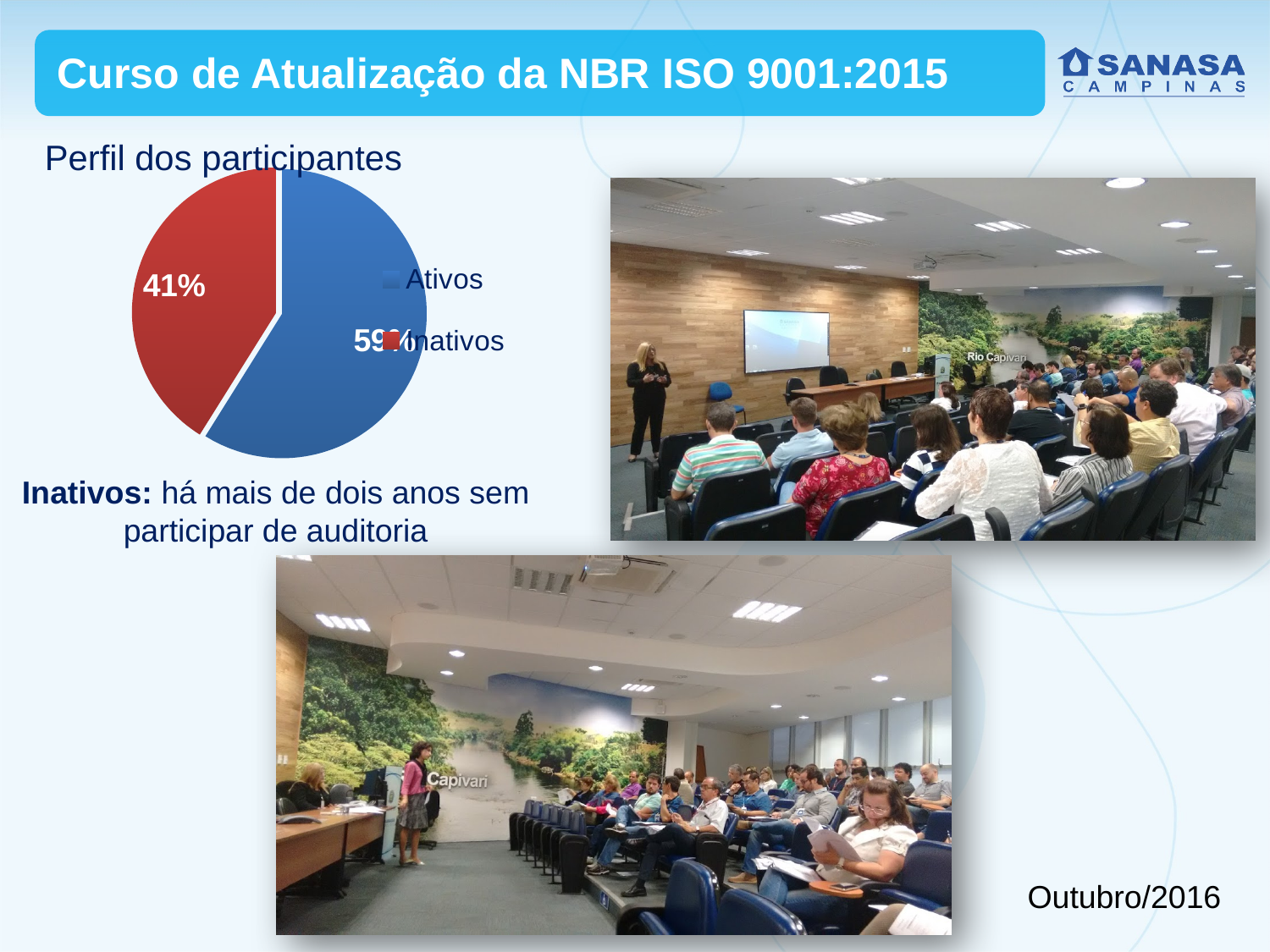
Which slice of the pie chart is the largest? Ativos Is the share for Inativos greater or less than 50%? less How many slices does the pie chart have? 2 What share of the pie chart is labelled for Ativos? 59% What is the difference in percentage points between the Ativos and Inativos slices? 18 What is the title shown above the pie chart? Perfil dos participantes What colour is the Inativos slice in the pie chart? red Which slice of the pie chart is the smallest? Inativos How many entries does the pie chart legend list? 2 What share of the pie chart is labelled for Inativos? 41% What kind of chart is shown under "Perfil dos participantes"? pie chart Which is larger in the pie chart, Ativos or Inativos? Ativos